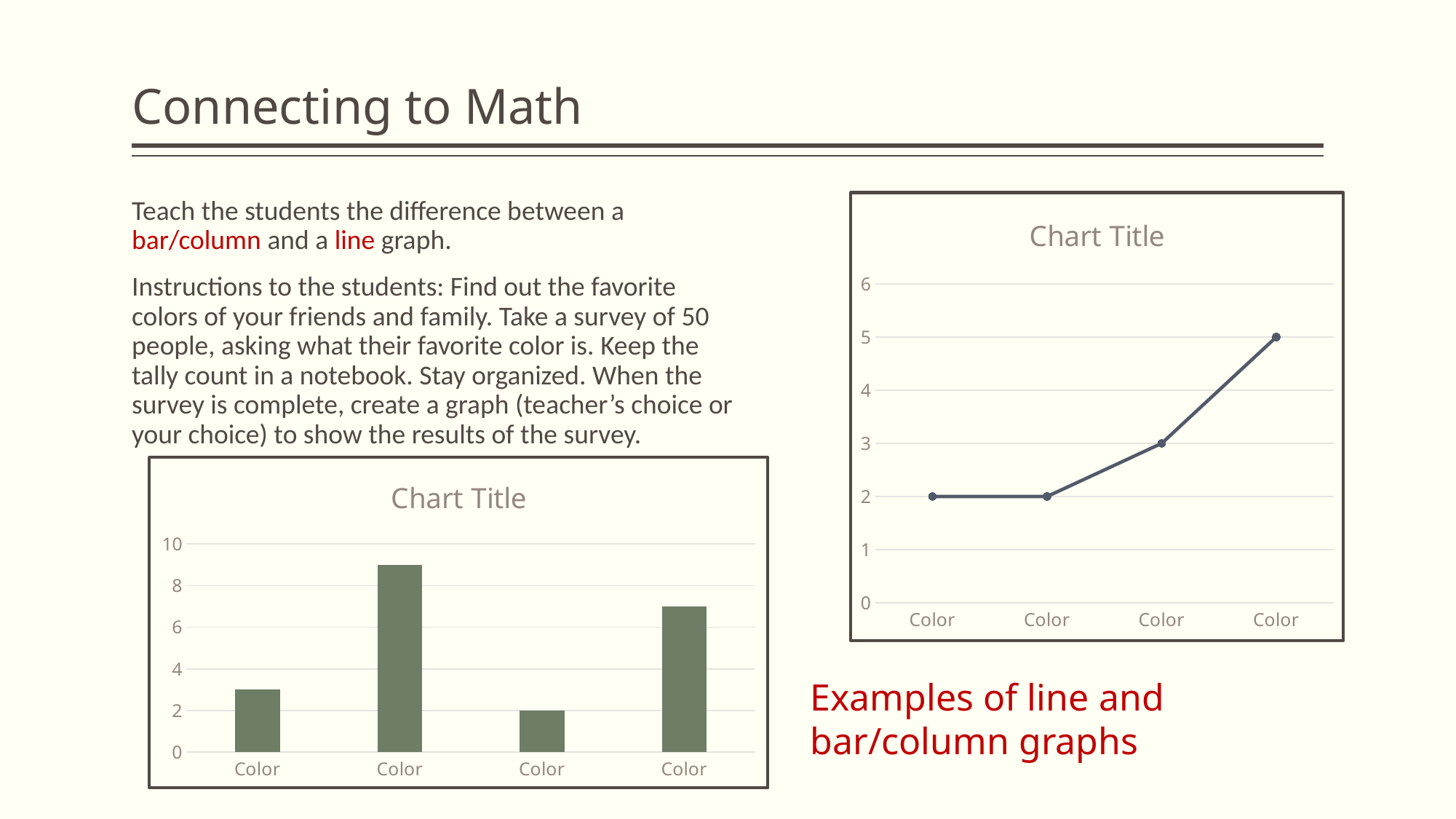
In the bar chart at the bottom-left, which bar is the shortest? the third bar In the line chart at the top-right, how many data points are plotted? 4 In the line chart at the top-right, what is the value of the third data point? 3 What kind of chart is the chart in the bottom-left of the slide? bar chart What kind of chart is the chart in the top-right of the slide? line chart In the bar chart at the bottom-left, is the value of the fourth bar greater or less than 8? less In the line chart at the top-right, what is the value of the last (fourth) data point? 5 In the line chart at the top-right, what is the difference between the fourth and third data points? 2 In the bar chart at the bottom-left, which bar is the tallest? the second bar In the bar chart at the bottom-left, how many bars are plotted? 4 In the line chart at the top-right, do the values rise or fall from left to right? rise In the bar chart at the bottom-left, is the value of the second bar greater or less than 8? greater